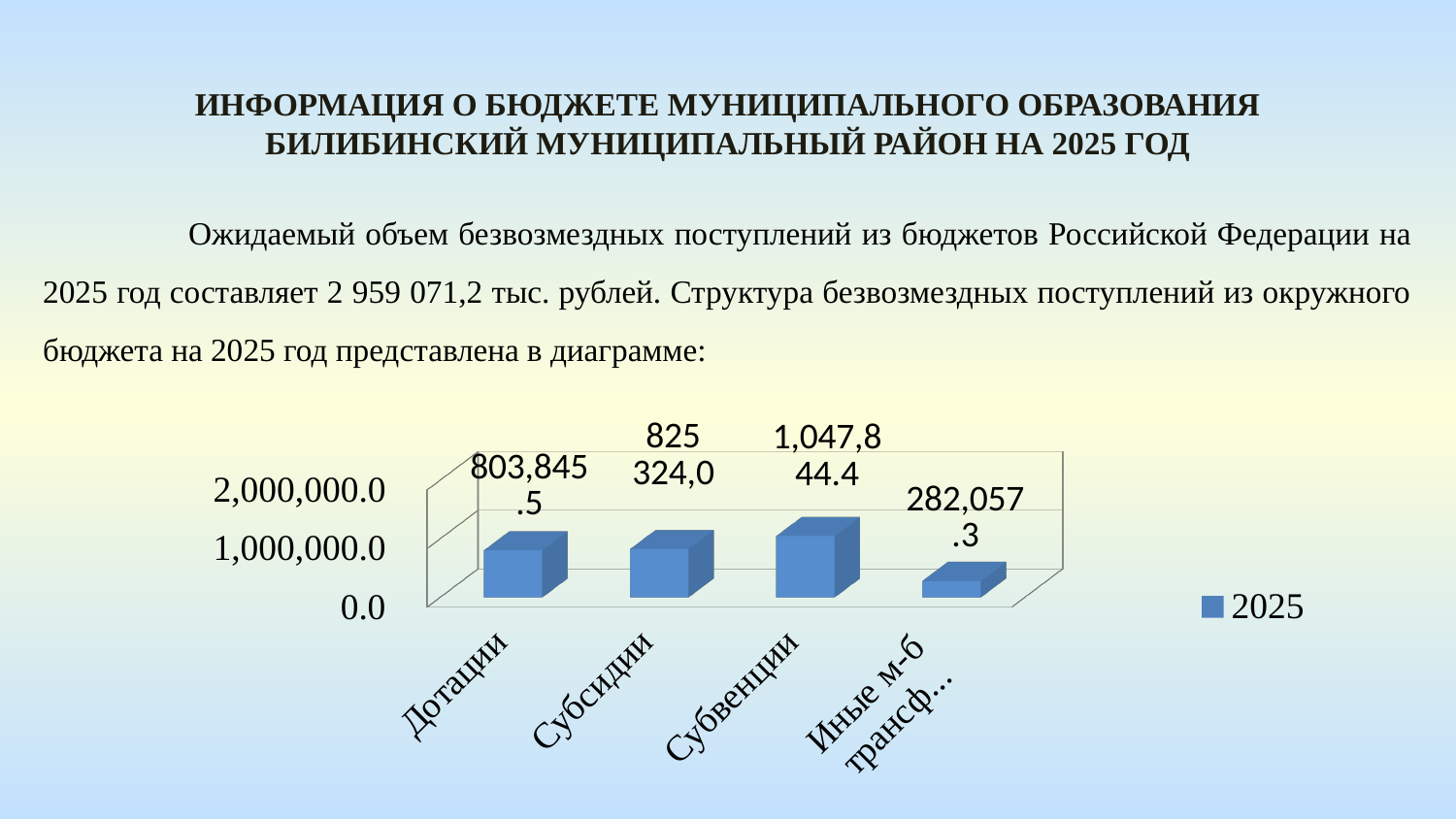
What is the difference between the values for Дотации and Иные м-б трансф...? 521,788.2 What kind of chart is shown on the slide? bar chart Which category has the highest value? Субвенции What is the difference between the values for Субвенции and Дотации? 243,998.9 Which category has the lowest value? Иные м-б трансф... How many series does the legend list? 1 Is the value for Субвенции greater or less than 1,000,000.0? greater How many categories are shown in the chart? 4 What is the value for the rightmost bar (Иные м-б трансф...)? 282,057.3 Which is larger, the value for Субсидии or the value for Дотации? Субсидии What is the value for Дотации? 803,845.5 What is the value for Субвенции? 1,047,844.4